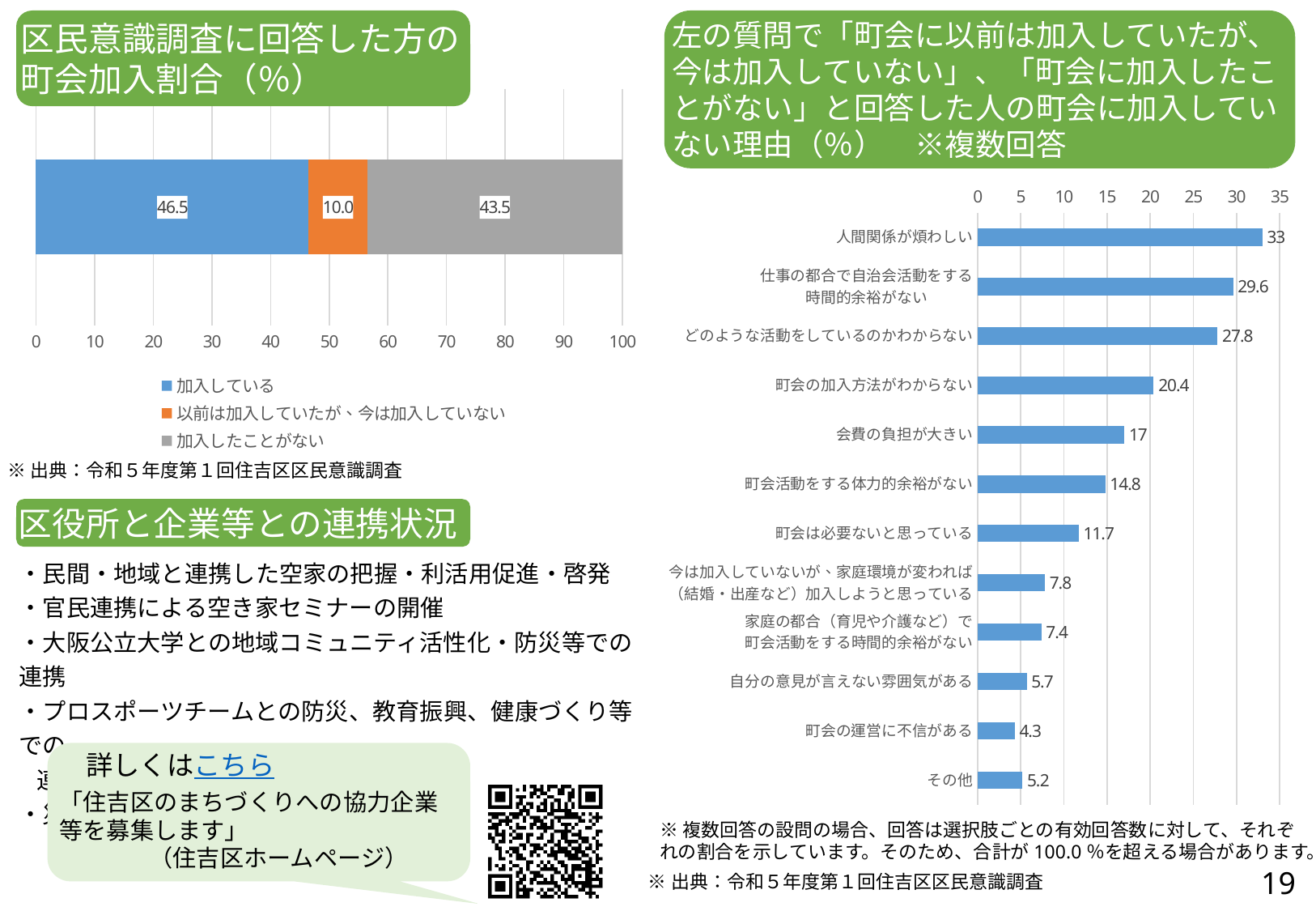
In the right chart (町会に加入していない理由), which reason has the highest value? 人間関係が煩わしい In the left chart (区民意識調査に回答した方の町会加入割合), how many series does the legend list? 3 In the right chart (町会に加入していない理由), what is the value for 会費の負担が大きい? 17 In the right chart (町会に加入していない理由), how many reasons (categories) are plotted? 12 In the left chart (区民意識調査に回答した方の町会加入割合), what is the total of the stacked bar? 100.0 In the left chart (区民意識調査に回答した方の町会加入割合), what is the difference between 加入している and 加入したことがない? 3.0 In the left chart (区民意識調査に回答した方の町会加入割合), what is the value for 以前は加入していたが、今は加入していない? 10.0 In the right chart (町会に加入していない理由), what is the value for 人間関係が煩わしい? 33 What kind of chart is the right chart (町会に加入していない理由)? bar chart In the right chart (町会に加入していない理由), which reason has the lowest value? 町会の運営に不信がある In the right chart (町会に加入していない理由), what is the difference between 仕事の都合で自治会活動をする時間的余裕がない and どのような活動をしているのかわからない? 1.8 In the left chart (区民意識調査に回答した方の町会加入割合), what is the value for 加入している? 46.5